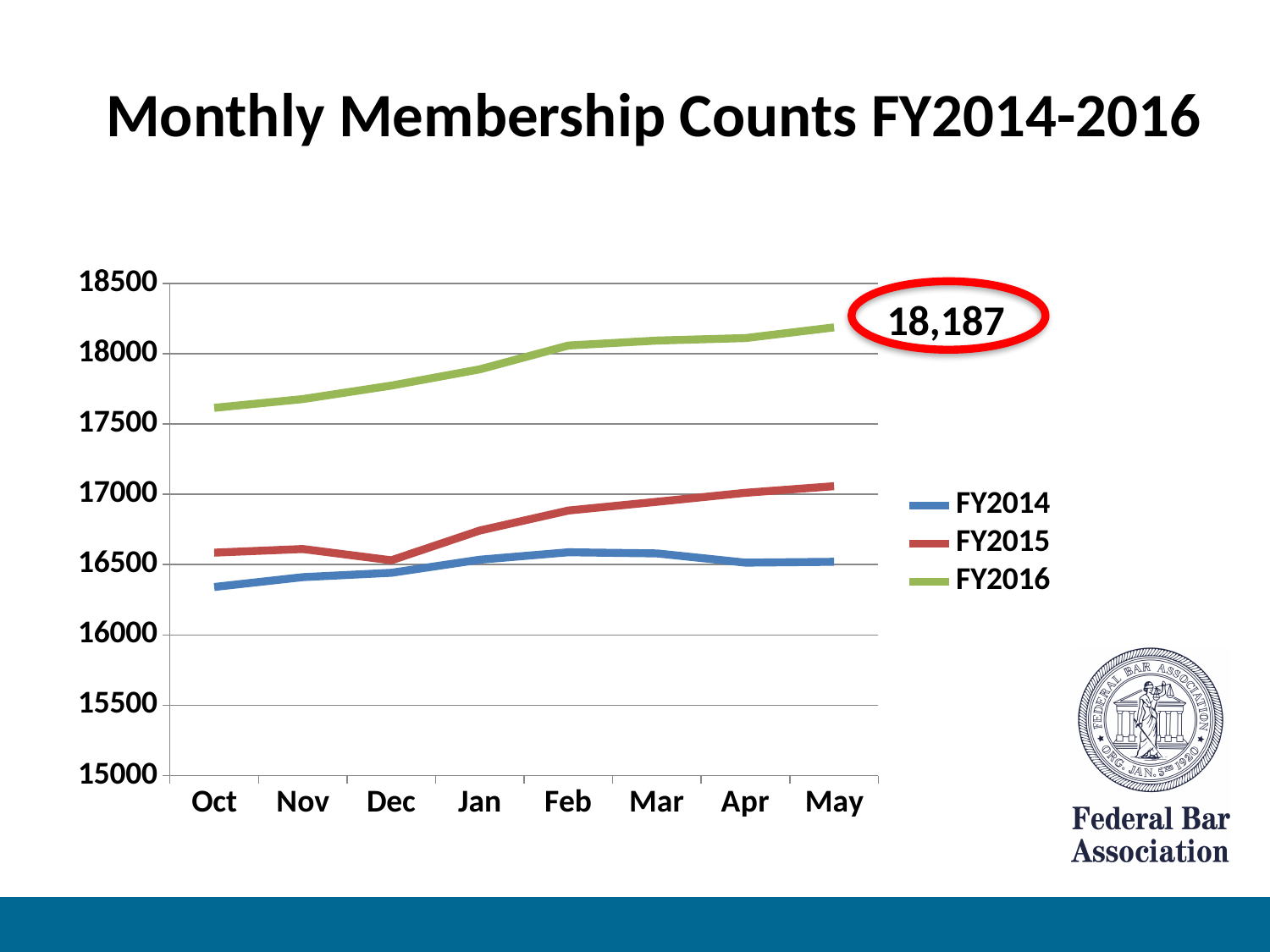
How many series does the legend list? 3 Is the value for FY2016 in Oct greater or less than 17500? greater How many months are shown on the x axis? 8 What is the title of the chart? Monthly Membership Counts FY2014-2016 Is the value for FY2015 in Oct greater or less than 17000? less Which series has the highest membership counts across all months? FY2016 What is the labelled value for FY2016 in May? 18,187 What kind of chart is shown on the slide? line chart Which is larger in May, the FY2015 value or the FY2014 value? FY2015 Which series has the lowest membership counts across all months? FY2014 Do the FY2016 values rise or fall from Oct to May? rise Is the value for FY2014 in Oct greater or less than 16500? less